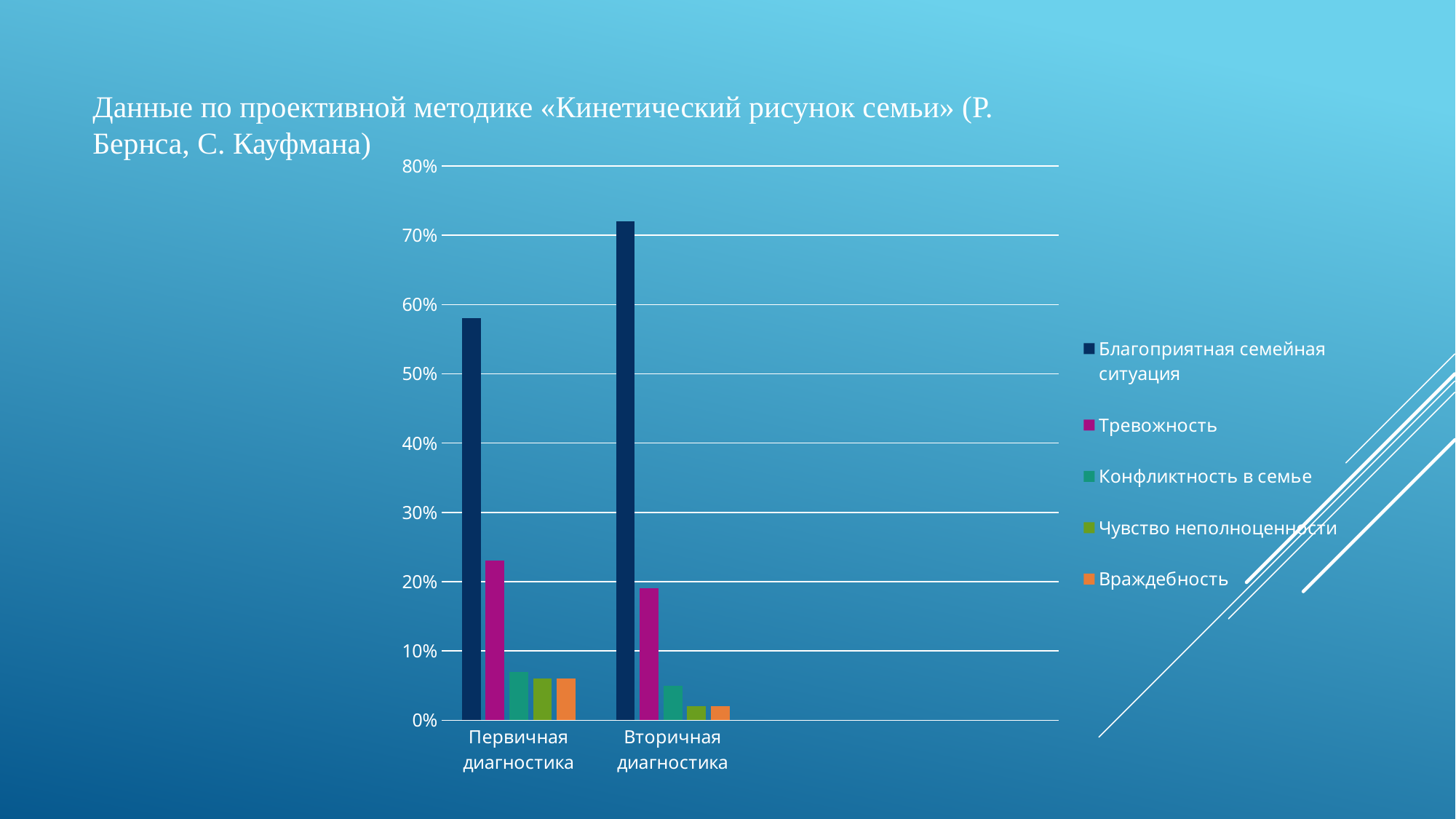
Which is larger: Благоприятная семейная ситуация for Первичная диагностика or for Вторичная диагностика? Вторичная диагностика Which series has the highest value for Первичная диагностика? Благоприятная семейная ситуация Is the value of Тревожность for Первичная диагностика greater or less than 20%? greater Is the value of Благоприятная семейная ситуация for Первичная диагностика greater or less than 60%? less Is the value of Благоприятная семейная ситуация for Вторичная диагностика greater or less than 70%? greater How many categories are shown on the x axis? 2 Does the value of Тревожность rise or fall from Первичная диагностика to Вторичная диагностика? fall What kind of chart is shown on the slide? bar chart Which series has the highest value for Вторичная диагностика? Благоприятная семейная ситуация Which colour represents Враждебность in the legend? orange How many series does the legend list? 5